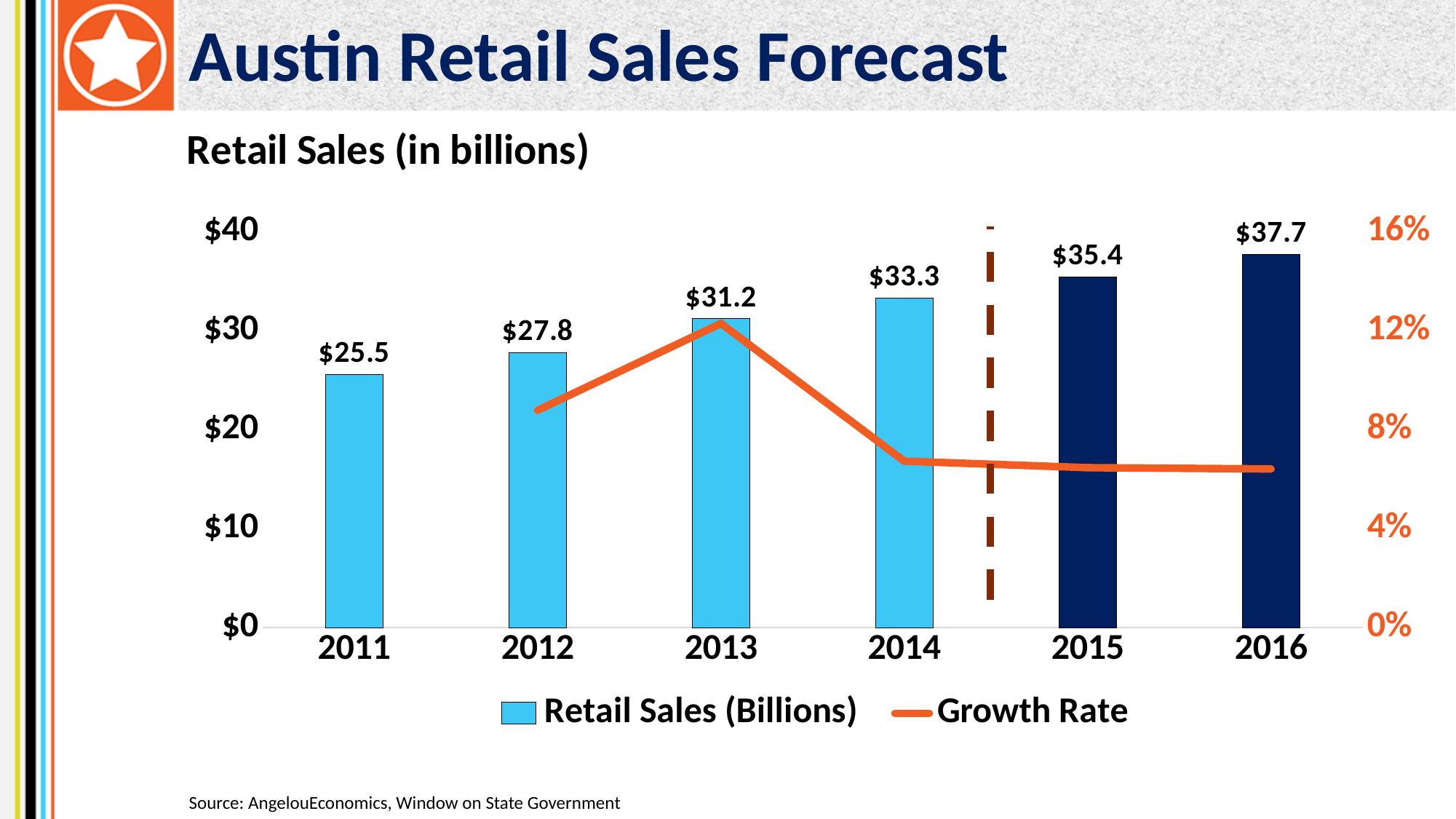
What is the Retail Sales value for 2016? $37.7 Which year has the lowest Retail Sales value? 2011 Is the Growth Rate for 2013 greater or less than 8%? greater Do the Retail Sales values rise or fall from 2011 to 2016? rise Is the Growth Rate for 2016 greater or less than 8%? less How many years are shown on the x axis? 6 How many series does the legend list? 2 What is the difference between the Retail Sales values for 2015 and 2014? $2.1 What is the title shown above the chart? Retail Sales (in billions) What is the Retail Sales value for 2013? $31.2 Which is larger, the Retail Sales value for 2012 or for 2014? 2014 Which year has the highest Retail Sales value? 2016